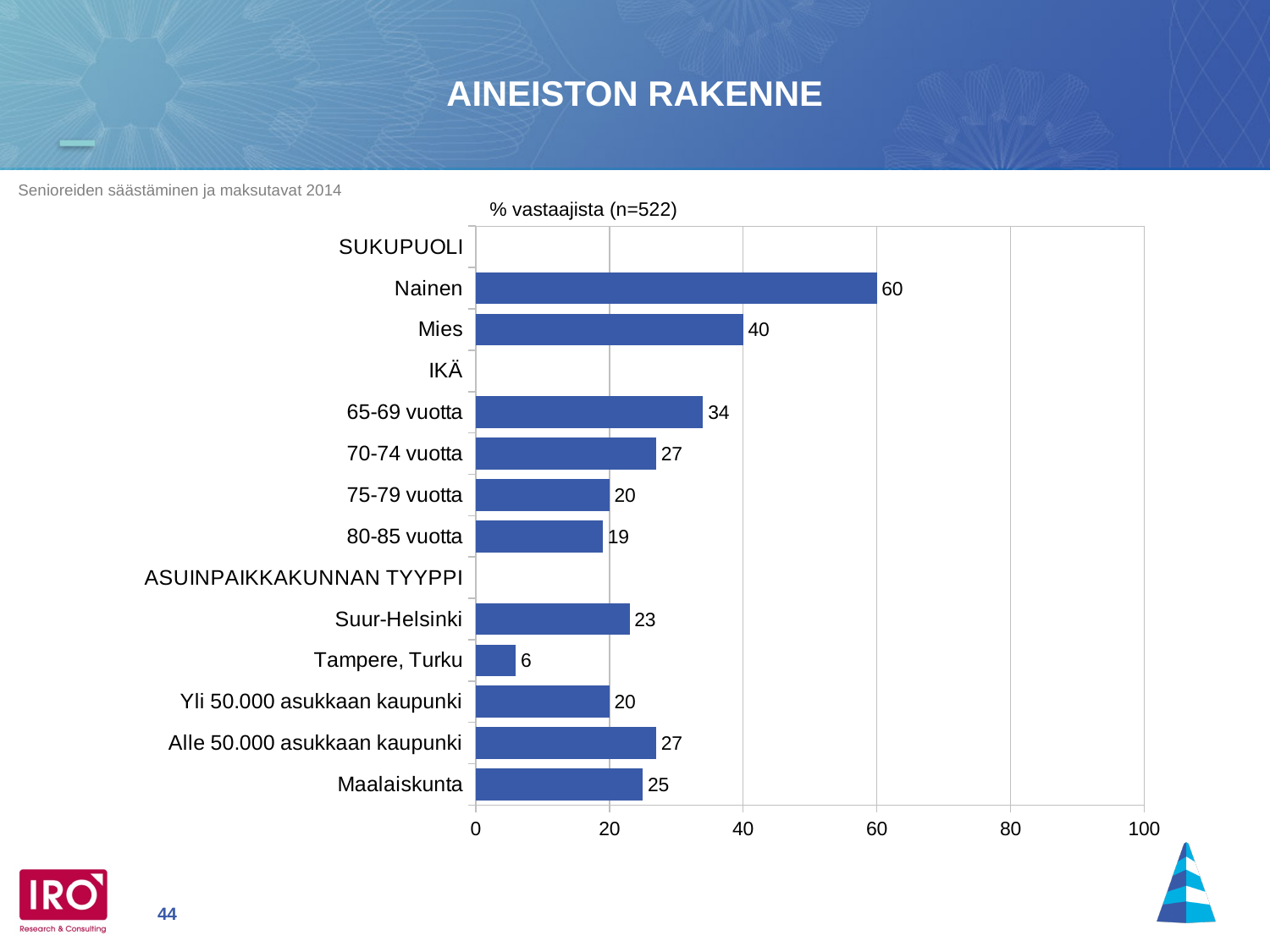
Is the value for 80-85 vuotta greater or less than 20? less What is the value for 65-69 vuotta? 34 What is the value for Tampere, Turku? 6 Do the values fall or rise going from 65-69 vuotta down to 80-85 vuotta? fall What kind of chart is shown on the slide? bar chart Which category has the highest value? Nainen What is the difference between the values for Nainen and Mies? 20 Which category has the lowest value? Tampere, Turku What is the value for Nainen? 60 Which is larger, the value for Suur-Helsinki or the value for Yli 50.000 asukkaan kaupunki? Suur-Helsinki What is the value for Maalaiskunta? 25 What is the title of the chart? % vastaajista (n=522)